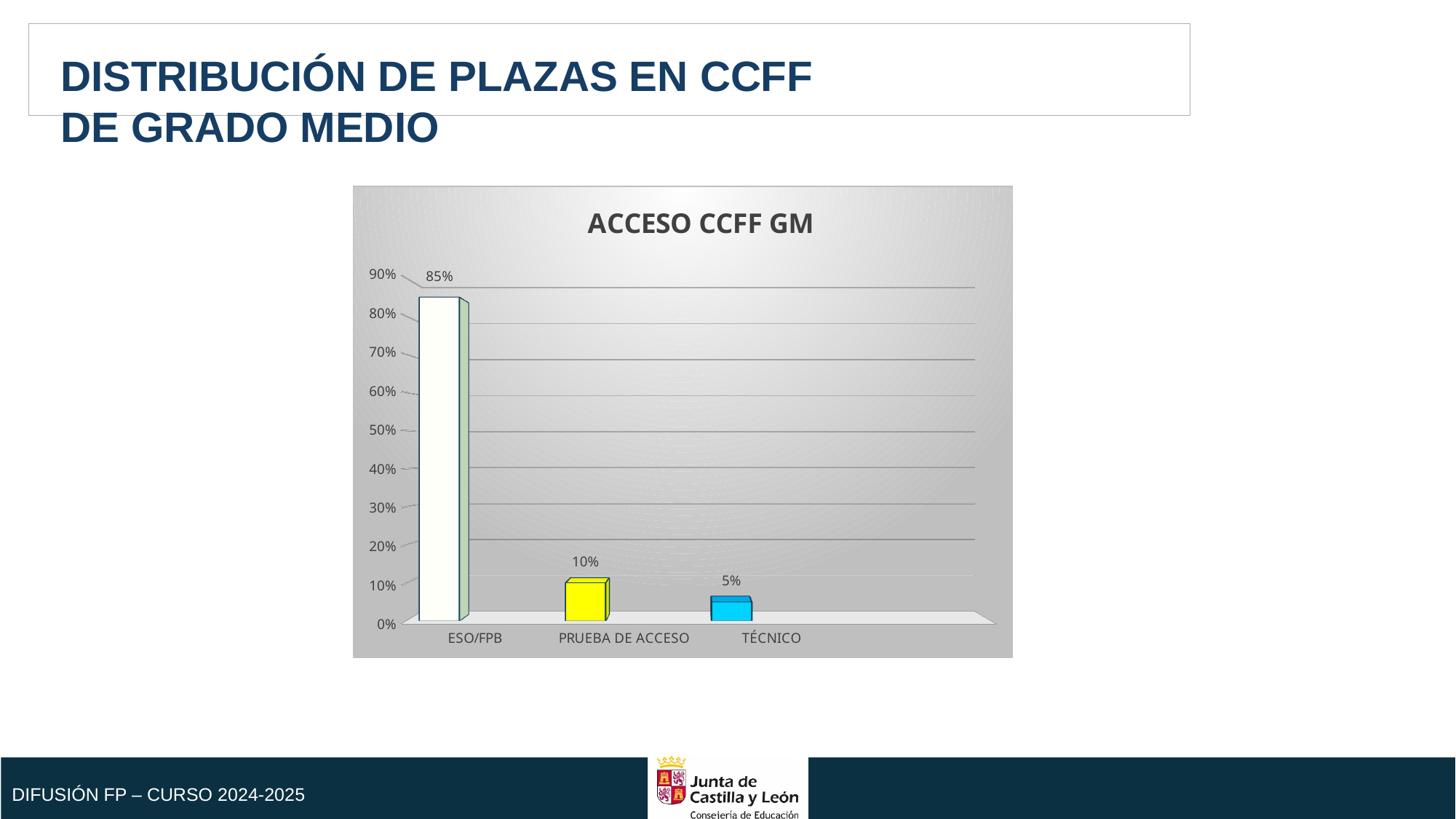
What is the difference between the values for PRUEBA DE ACCESO and TÉCNICO? 5% What is the value for TÉCNICO? 5% How many categories are shown on the x axis? 3 What is the value for ESO/FPB? 85% What is the difference between the values for ESO/FPB and PRUEBA DE ACCESO? 75% What is the value for PRUEBA DE ACCESO? 10% Which category has the highest value? ESO/FPB What is the title of the chart? ACCESO CCFF GM Which is larger, the value for PRUEBA DE ACCESO or the value for TÉCNICO? PRUEBA DE ACCESO What kind of chart is shown? bar chart Is the value for ESO/FPB greater or less than 80%? greater Which category has the lowest value? TÉCNICO